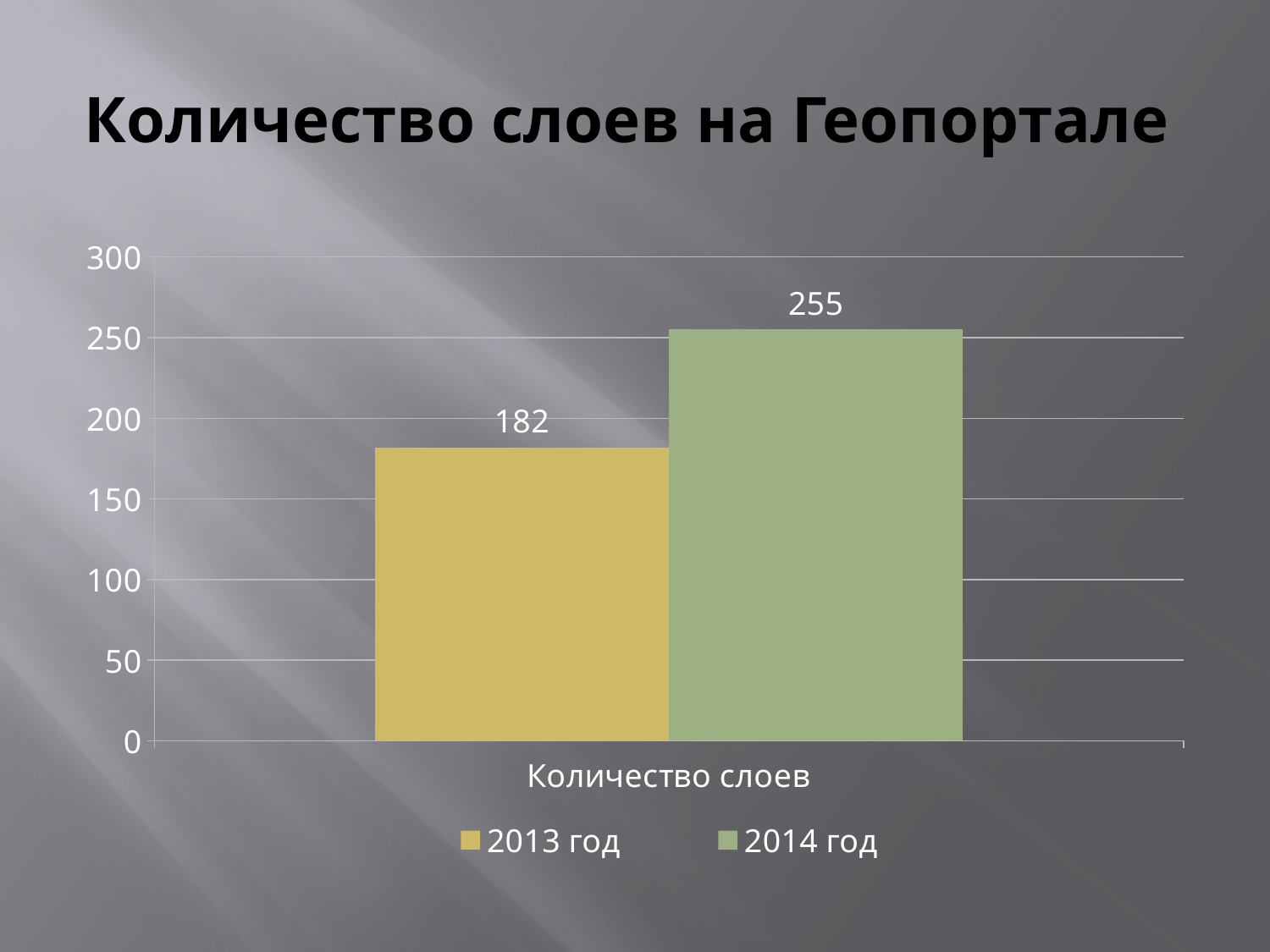
What is the difference between the values for 2014 год and 2013 год? 73 What is the category label on the x axis? Количество слоев What kind of chart is shown on the slide? bar chart Which series has the higher value, 2013 год or 2014 год? 2014 год How many series does the legend list? 2 Which series has the lowest value? 2013 год What is the value for 2014 год? 255 What is the value for 2013 год? 182 What is the maximum value shown on the y axis? 300 Is the value for 2014 год greater or less than 250? greater Is the value for 2013 год greater or less than 200? less What is the title of the chart? Количество слоев на Геопортале